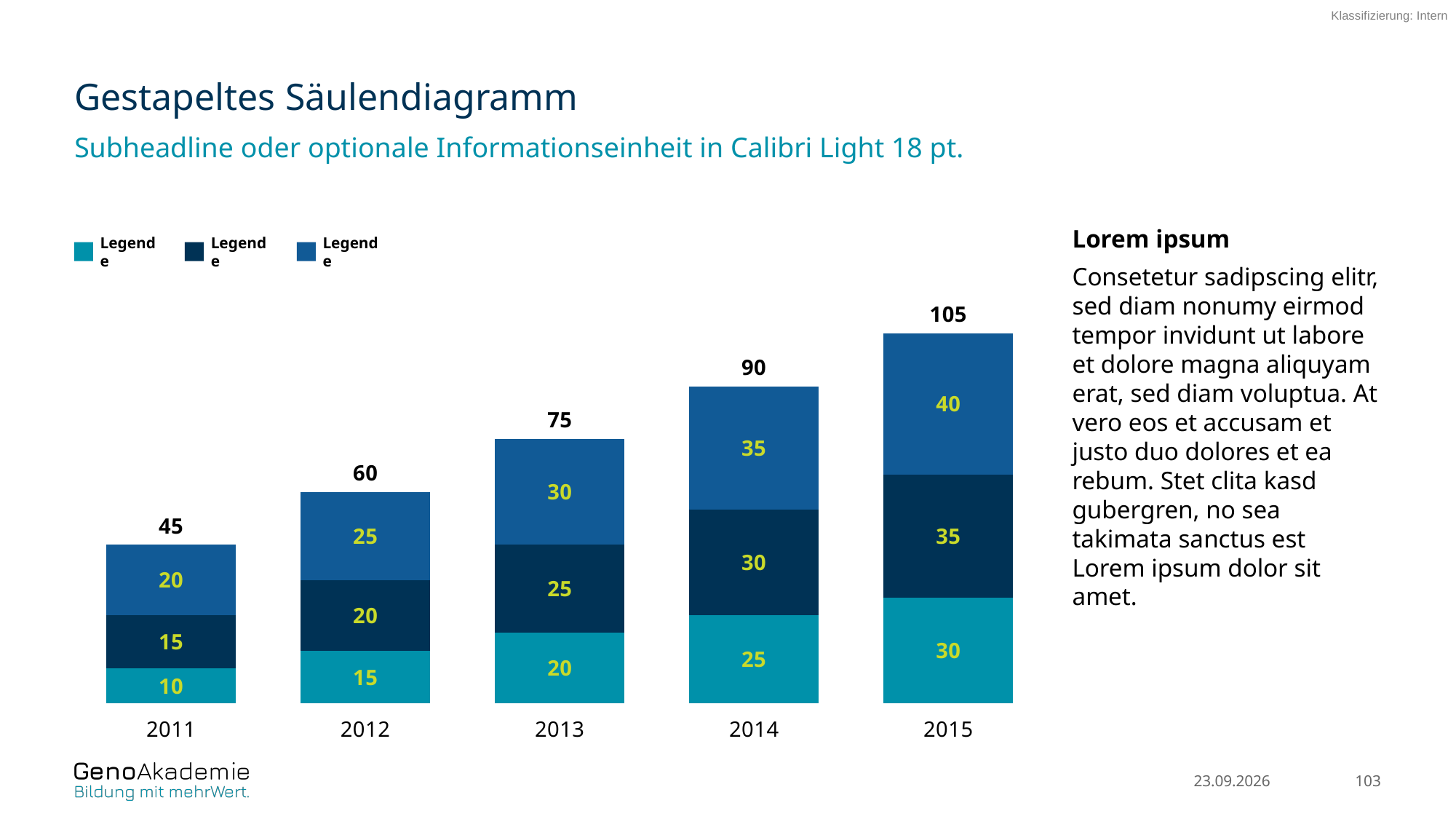
What is the total value of the stacked bar for 2013? 75 How many years are shown on the x axis of the chart? 5 What is the value of the bottom (teal) segment of the 2014 bar? 25 How many series does the chart's legend list? 3 Do the total values rise or fall from 2011 to 2015? rise Which year has the highest total value? 2015 What is the difference between the total for 2015 and the total for 2011? 60 What is the value of the top segment of the 2012 bar? 25 What is the total value of the stacked bar for 2015? 105 What kind of chart is shown on the slide? stacked bar chart What is the value of the middle (dark navy) segment of the 2011 bar? 15 Which year has the lowest total value? 2011